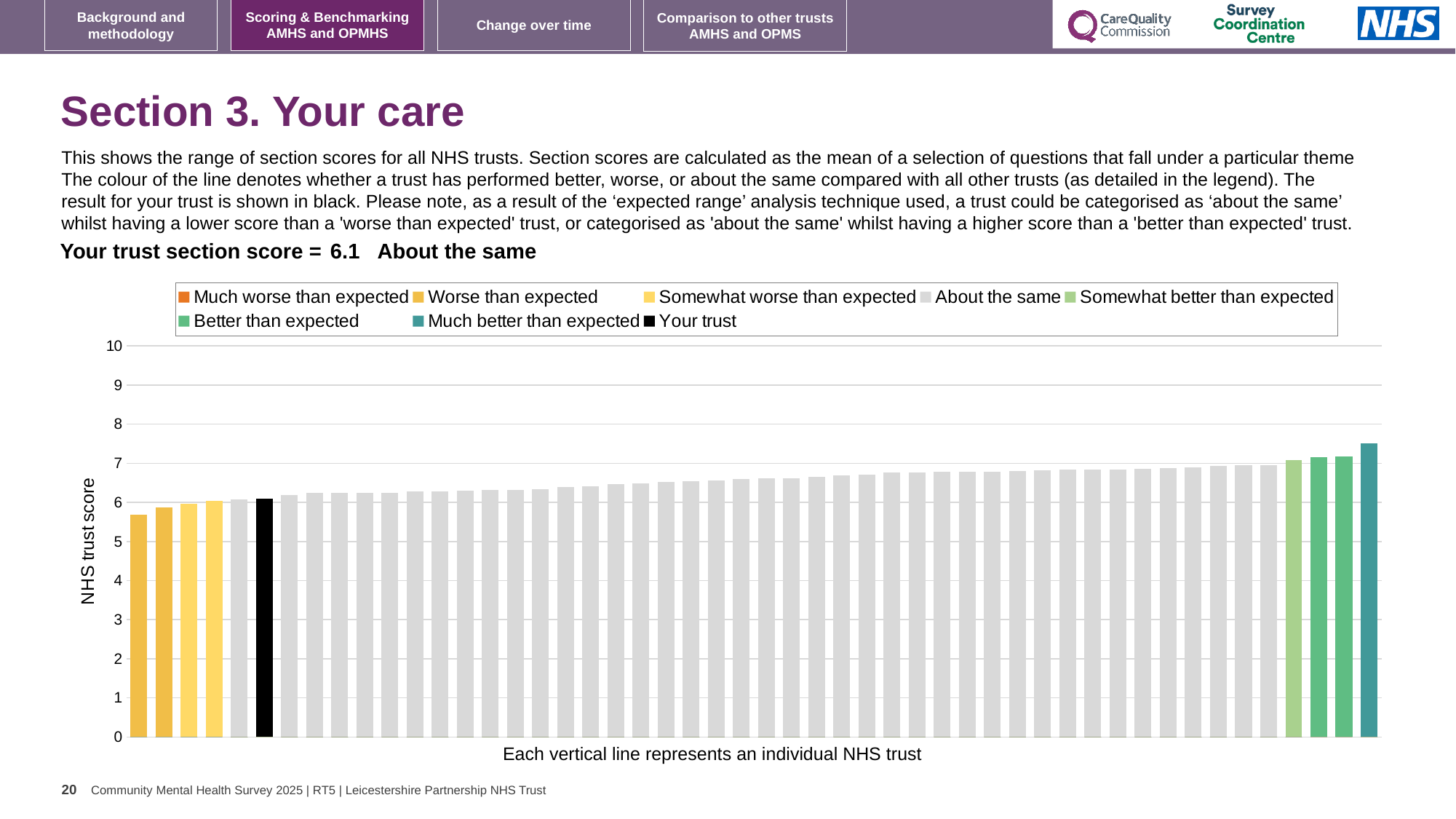
Is the value for your trust (the black bar) greater or less than 5? greater Is the value of the tallest bar in the chart greater or less than 7? greater Is the value of the shortest bar in the chart greater or less than 6? less How is your trust's section score categorised compared with other trusts? About the same What is the label on the vertical axis of the chart? NHS trust score What is the section score for your trust shown on the slide? 6.1 What kind of chart is shown on the slide? Bar chart How many entries does the chart legend list? 8 What colour is used for the bar representing your trust? Black Do the bar values rise or fall moving from left to right along the x axis? rise What is the highest value shown on the vertical axis? 10 Which legend category does the tallest bar belong to? Much better than expected